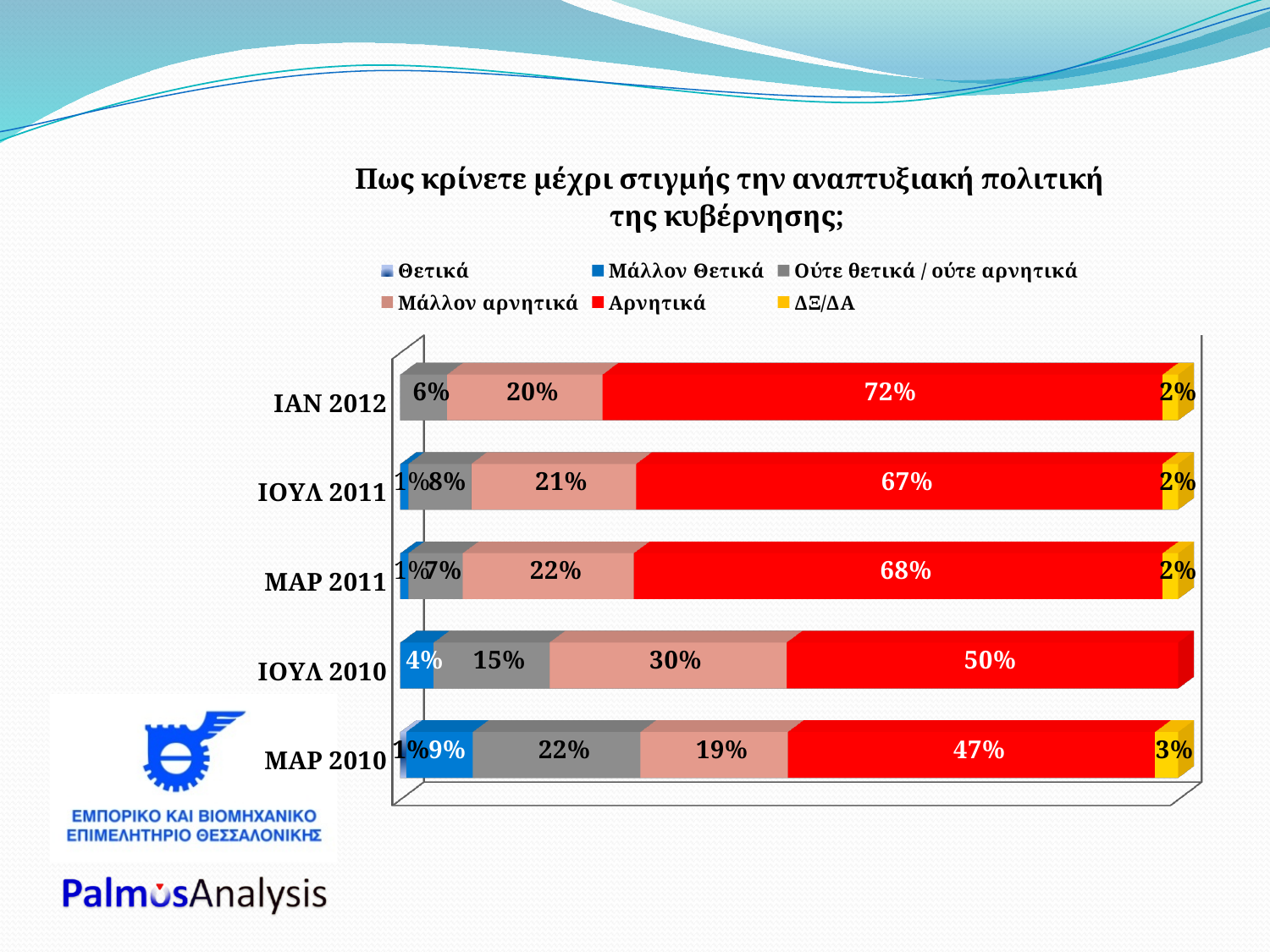
What kind of chart is shown on the slide? Stacked bar chart What is the Αρνητικά value for ΜΑΡ 2010? 47% How many survey waves (categories) are shown on the chart? 5 Which is larger: the Μάλλον αρνητικά value for ΙΟΥΛ 2010 or for ΜΑΡ 2010? ΙΟΥΛ 2010 What percentage of respondents answered Αρνητικά in ΙΑΝ 2012? 72% In which survey wave is the Αρνητικά share the highest? ΙΑΝ 2012 How many series does the legend list? 6 What is the ΔΞ/ΔΑ value for ΜΑΡ 2010? 3% What is the difference between the Αρνητικά values for ΙΑΝ 2012 and ΙΟΥΛ 2011? 5% In which survey wave is the Αρνητικά share the lowest? ΜΑΡ 2010 What is the Μάλλον αρνητικά value for ΙΟΥΛ 2010? 30% What is the Ούτε θετικά / ούτε αρνητικά value for ΙΟΥΛ 2010? 15%